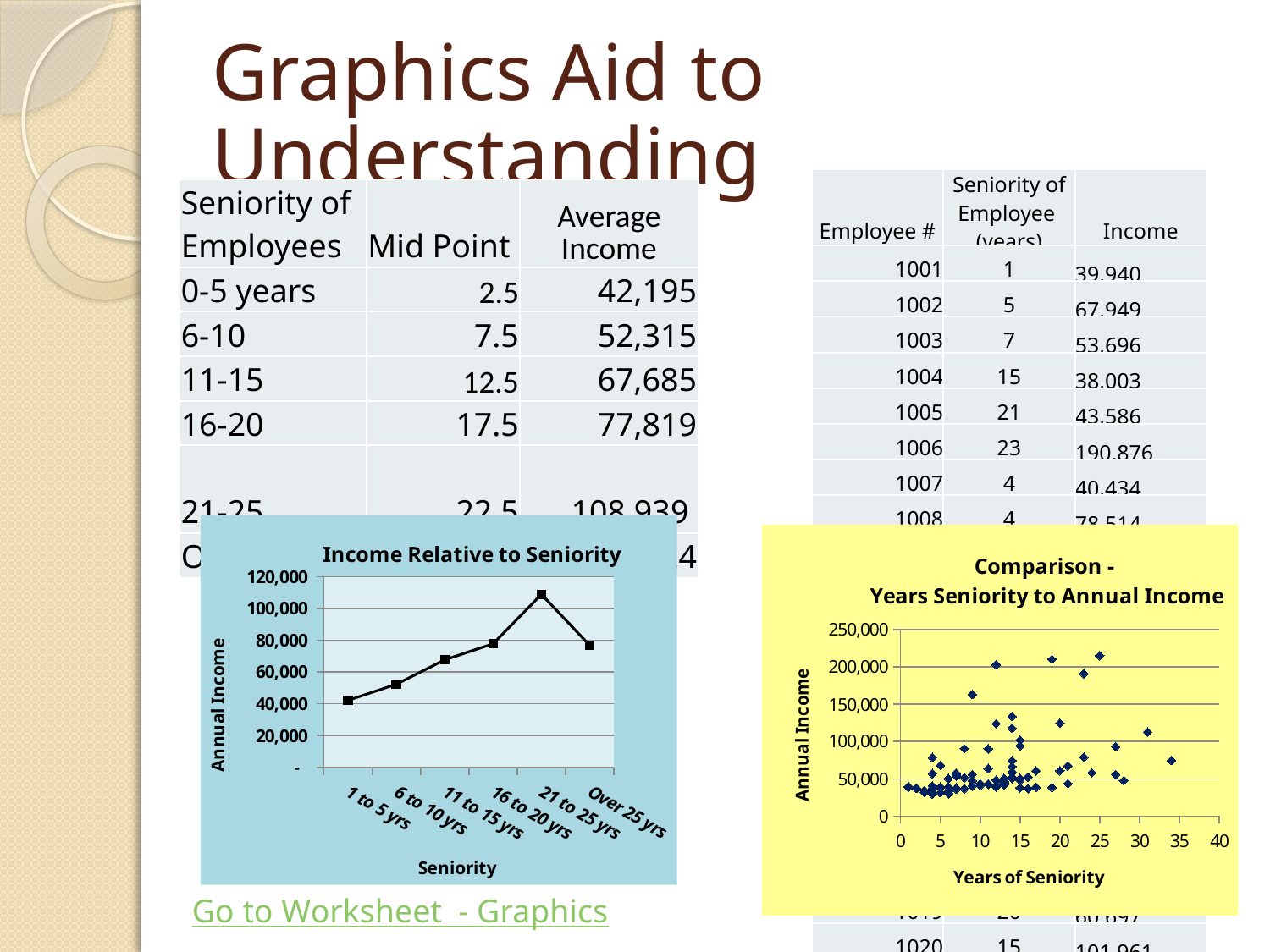
In the "Income Relative to Seniority" chart, how many seniority categories are shown on the x axis? 6 In the "Income Relative to Seniority" chart, is the value for 21 to 25 yrs greater or less than 100,000? greater What kind of chart is "Comparison - Years Seniority to Annual Income"? scatter chart In the "Income Relative to Seniority" chart, do the values rise or fall from 1 to 5 yrs through 21 to 25 yrs? rise What kind of chart is "Income Relative to Seniority"? line chart In the "Income Relative to Seniority" chart, which has the higher annual income, 6 to 10 yrs or 11 to 15 yrs? 11 to 15 yrs In the "Income Relative to Seniority" chart, is the value for 1 to 5 yrs greater or less than 60,000? less In the "Income Relative to Seniority" chart, which seniority category has the highest annual income? 21 to 25 yrs In the "Comparison - Years Seniority to Annual Income" chart, what is the title of the horizontal axis? Years of Seniority In the "Income Relative to Seniority" chart, which seniority category has the lowest annual income? 1 to 5 yrs In the "Comparison - Years Seniority to Annual Income" chart, is the highest plotted income greater or less than 200,000? greater In the "Income Relative to Seniority" chart, what is the title of the vertical axis? Annual Income